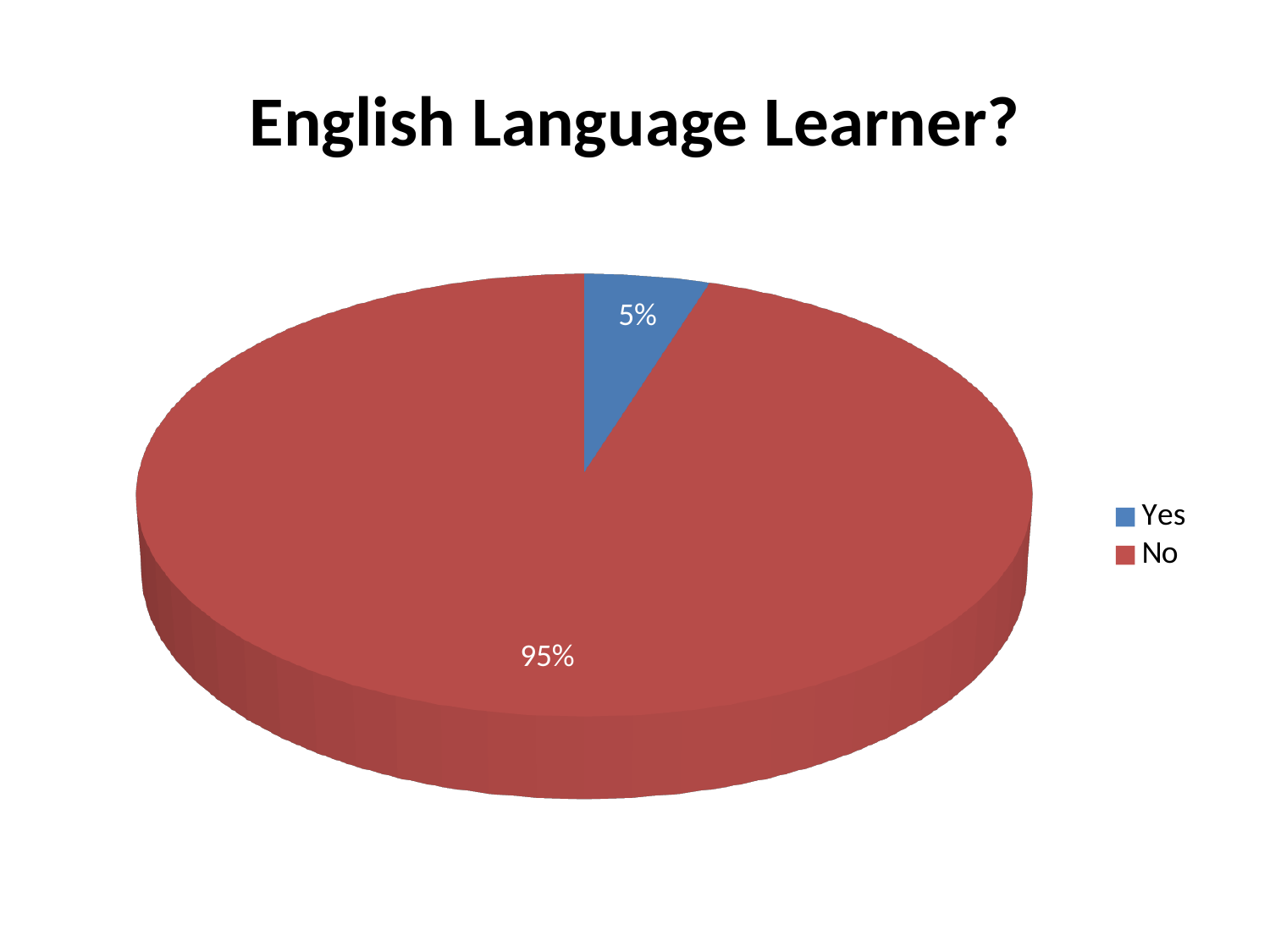
How many slices does the pie chart have? 2 Which slice is larger, "Yes" or "No"? No How many entries does the legend list? 2 What is the title of the chart? English Language Learner? What kind of chart is shown on the slide? Pie chart Which category has the smallest slice of the pie? Yes What share of the pie is labelled "No"? 95% What share of the pie is labelled "Yes"? 5% Which category has the largest slice of the pie? No What is the difference in percentage points between the "No" slice and the "Yes" slice? 90 What colour is the "Yes" slice? Blue